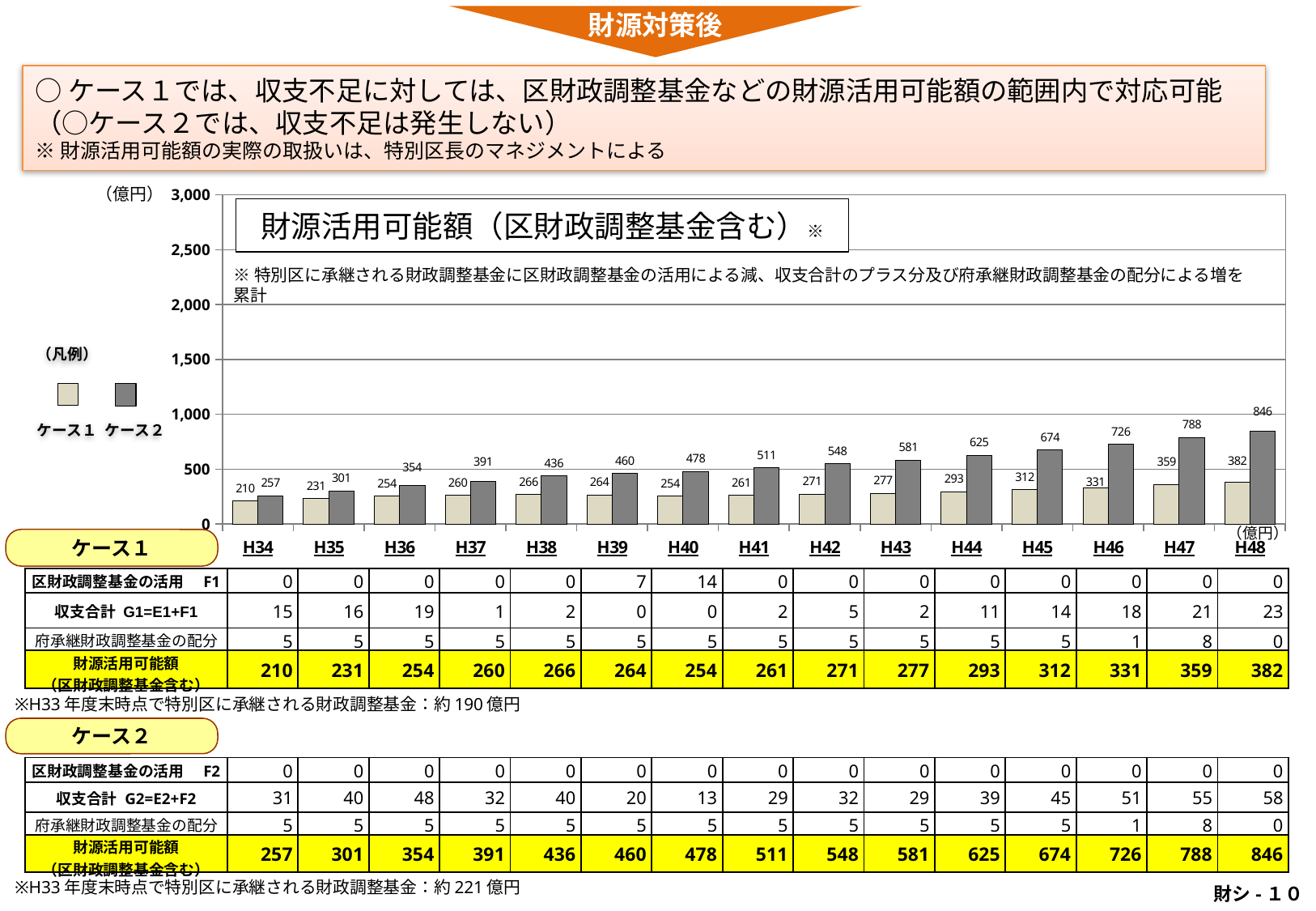
What is the difference between ケース２ and ケース１ in H48? 464 What kind of chart is shown on the slide? bar chart What is the value for ケース１ in H45? 312 What is the value for ケース２ in H48? 846 How many years are shown on the x axis of the chart? 15 What is the value for ケース２ in H41? 511 What is the difference between the ケース１ values in H38 and H40? 12 In which year is the ケース２ value highest? H48 In which year is the ケース１ value lowest? H34 Which is larger in H36, ケース１ or ケース２? ケース２ How many series does the legend list? 2 What is the value for ケース１ in H34? 210